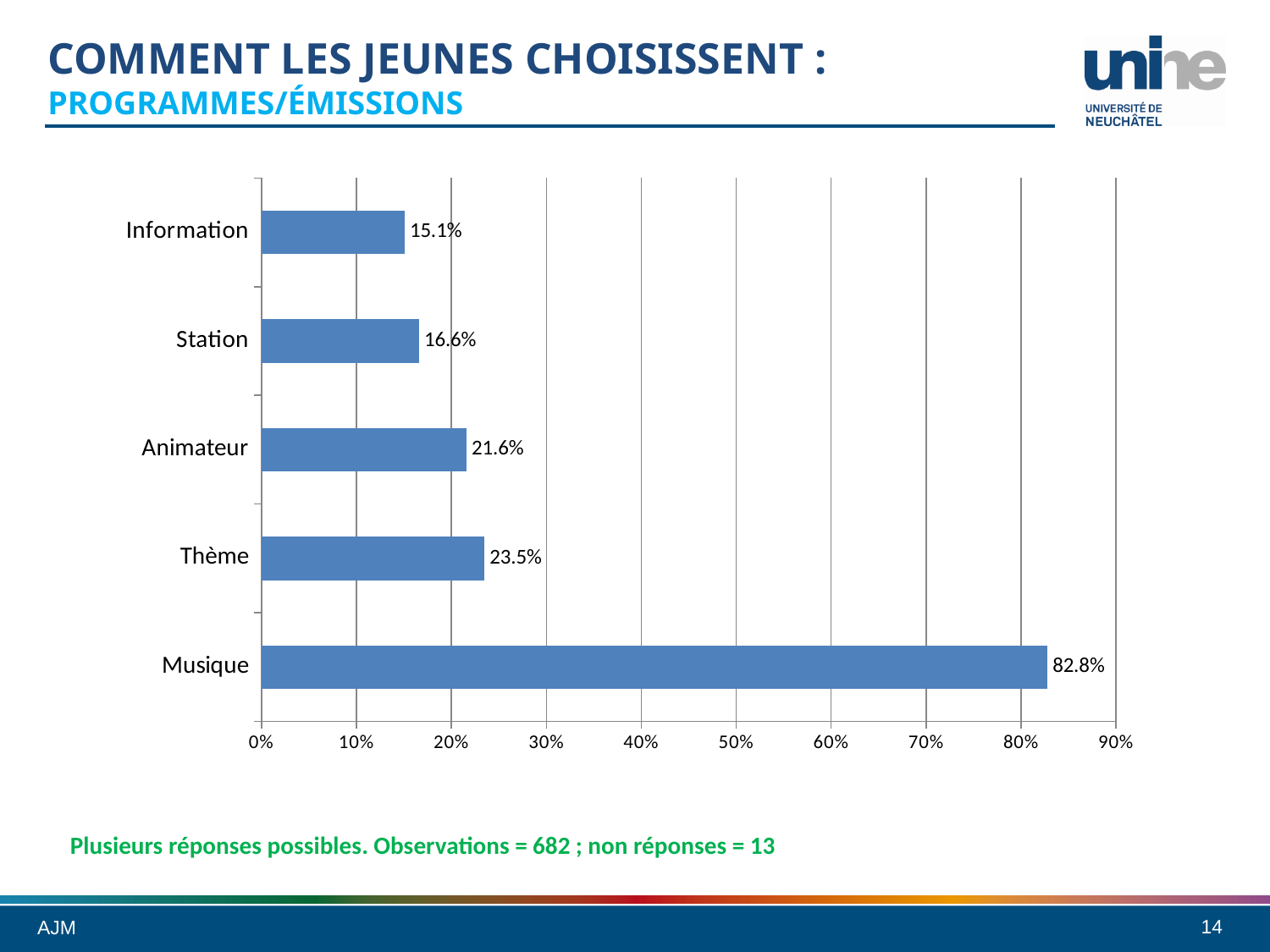
What kind of chart is shown on the slide? Bar chart What is the difference between the values for Musique and Thème? 59.3% Which category has the lowest value? Information What is the value for Information? 15.1% Is the value for Musique greater or less than 80%? greater Which is larger, the value for Animateur or the value for Station? Animateur Which category has the highest value? Musique What is the value for Station? 16.6% What is the value for Musique? 82.8% What is the value for Animateur? 21.6% What is the value for Thème? 23.5% How many categories are shown in the chart? 5